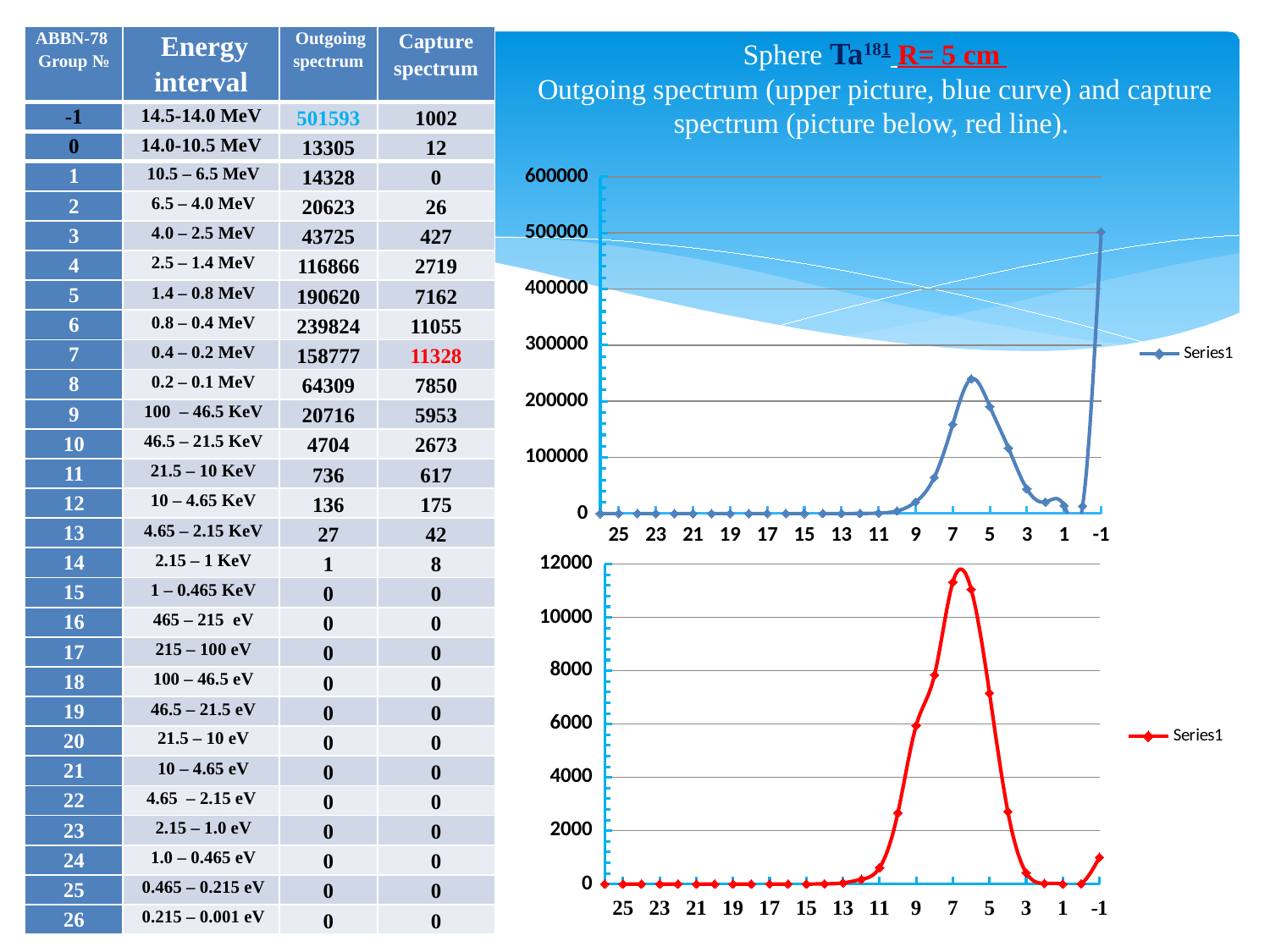
In the upper chart, is the value at group -1 greater or less than 400000? greater What kind of chart is the upper chart on the slide? line chart In the lower chart, is the value at group 9 greater or less than 4000? greater In the upper chart, is the value at group 8 greater or less than 100000? less What kind of chart is the lower chart on the slide? line chart In the lower chart, do the values rise or fall going from group 7 to group 3 along the x axis? fall In the upper chart, which x-axis group has the highest value? -1 How many series does the legend of the upper chart list? 1 What colour is the line in the lower chart? red